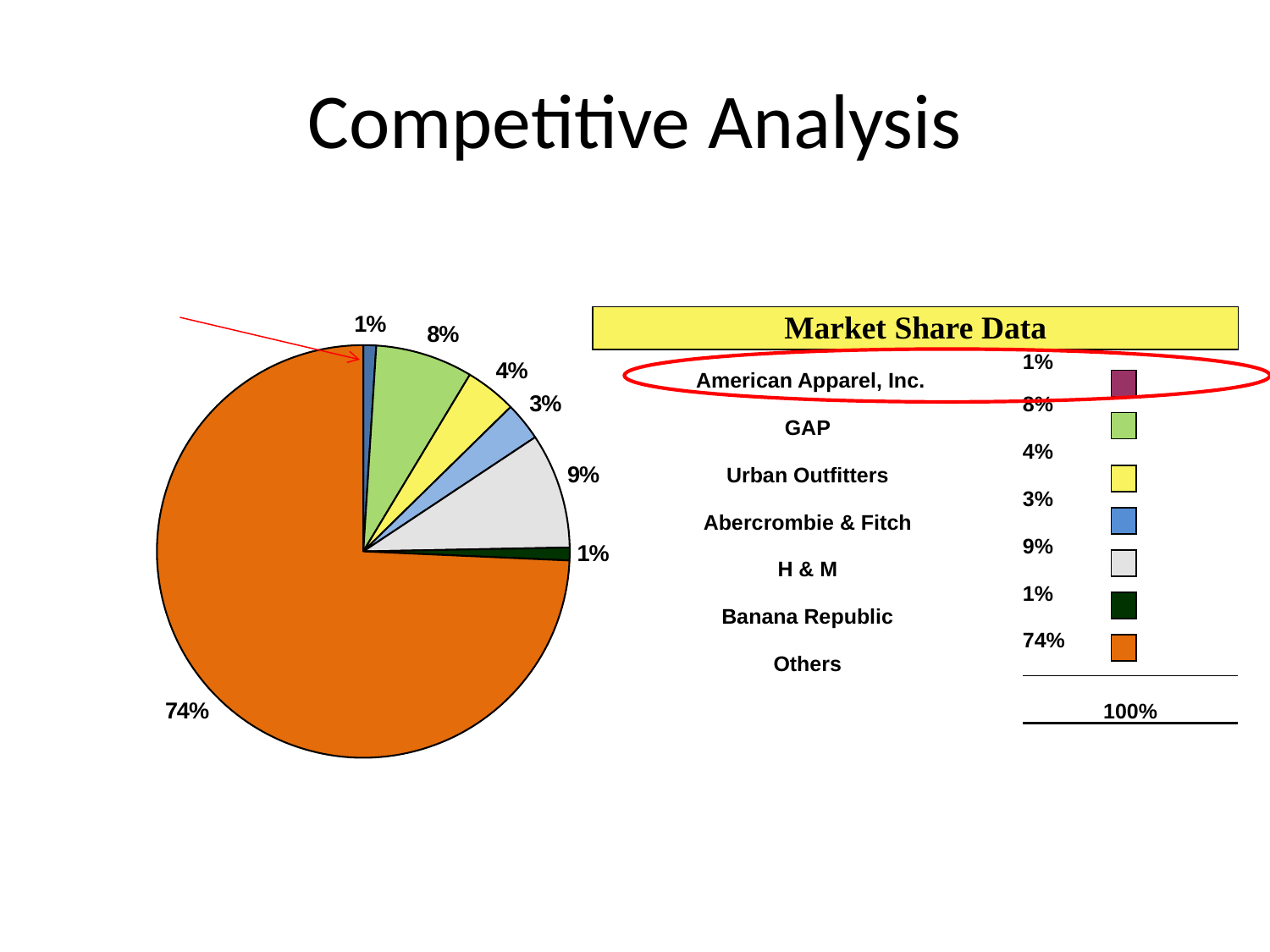
What is the market share for Urban Outfitters? 4% Which named company (excluding Others) has the largest market share? H & M What is the market share for American Apparel, Inc.? 1% Which has a larger market share, Urban Outfitters or Abercrombie & Fitch? Urban Outfitters What kind of chart is shown on the slide? pie chart What is the market share for Abercrombie & Fitch? 3% What is the market share for H & M? 9% Which category has the largest slice of the pie? Others How many categories are shown in the pie chart? 7 What is the market share for GAP? 8% What is the difference in market share between H & M and GAP? 1% What is the title of the legend table next to the pie chart? Market Share Data